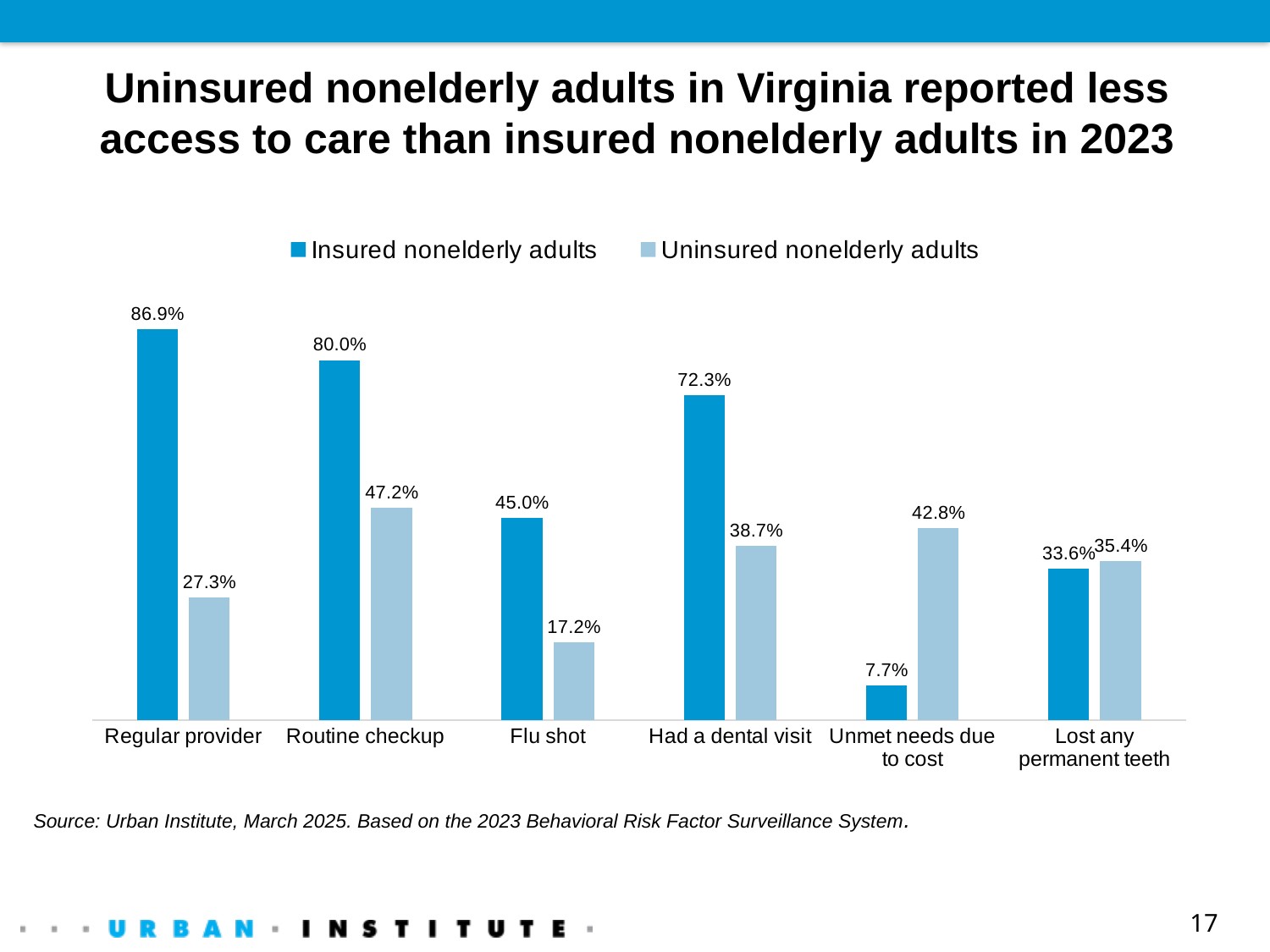
What kind of chart is shown on the slide? Bar chart What is the value for uninsured nonelderly adults for Unmet needs due to cost? 42.8% What is the value for insured nonelderly adults for Regular provider? 86.9% How many series does the legend list? 2 Which category has the lowest value for uninsured nonelderly adults? Flu shot For Lost any permanent teeth, which is larger: the value for insured or uninsured nonelderly adults? Uninsured nonelderly adults What is the difference between insured and uninsured nonelderly adults for Routine checkup? 32.8 percentage points What is the value for uninsured nonelderly adults for Flu shot? 17.2% How many categories are shown on the x axis? 6 Which category has the highest value for insured nonelderly adults? Regular provider Which category has the lowest value for insured nonelderly adults? Unmet needs due to cost For Had a dental visit, which is larger: the value for insured or uninsured nonelderly adults? Insured nonelderly adults